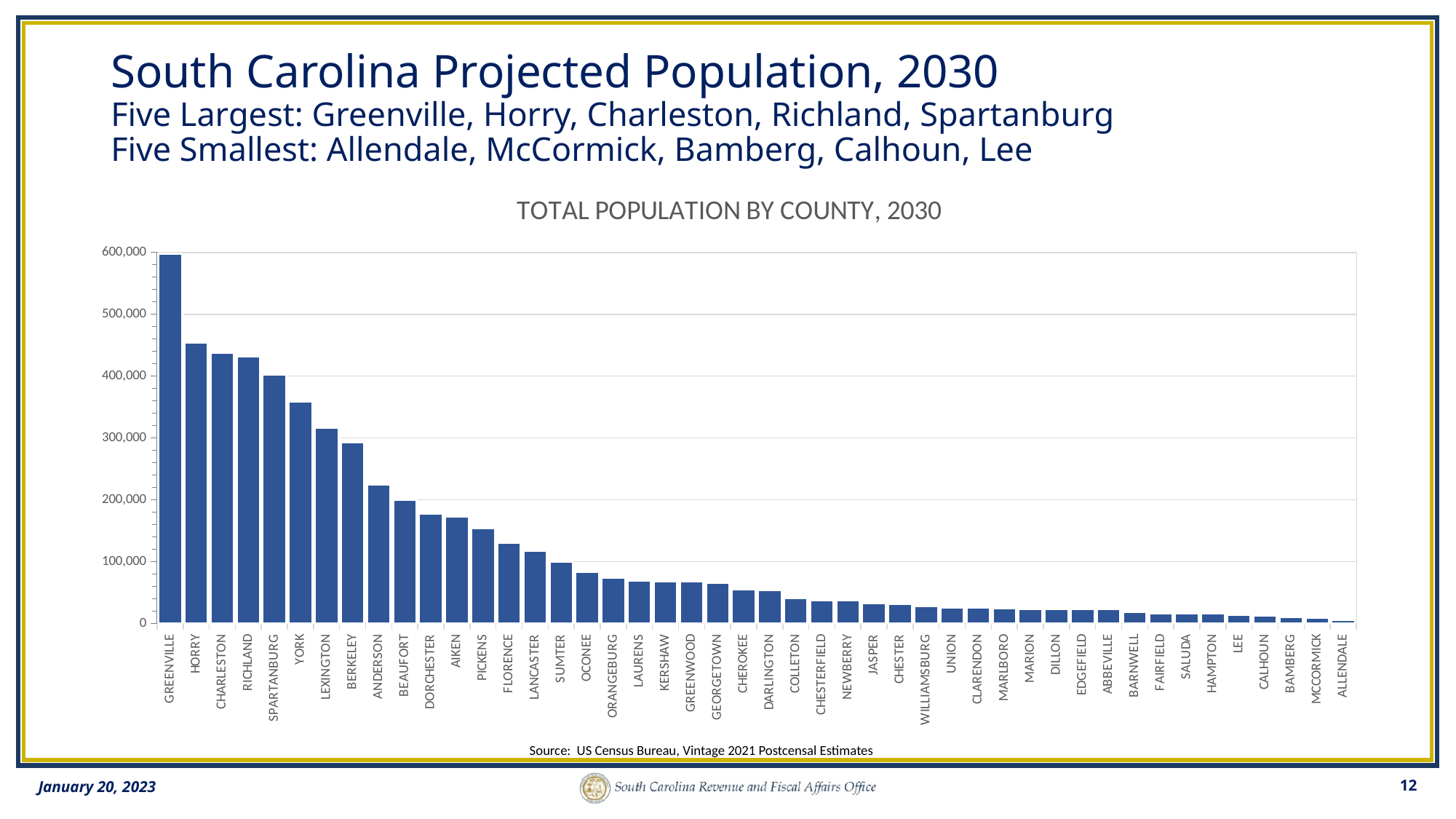
Which has the larger projected population, Aiken or Florence? Aiken How many counties are shown on the x axis of the chart? 46 Which county has the lowest projected 2030 population in the chart? Allendale Which county has the highest projected 2030 population in the chart? Greenville Is the value for Greenville greater or less than 500,000? greater Is the value for Oconee greater or less than 100,000? less Is the value for Anderson greater or less than 200,000? greater Do the bar values rise or fall moving from left to right along the x axis? Fall Which has the larger projected population, York or Lexington? York What is the title of the chart? TOTAL POPULATION BY COUNTY, 2030 What kind of chart is shown on the slide? Bar chart